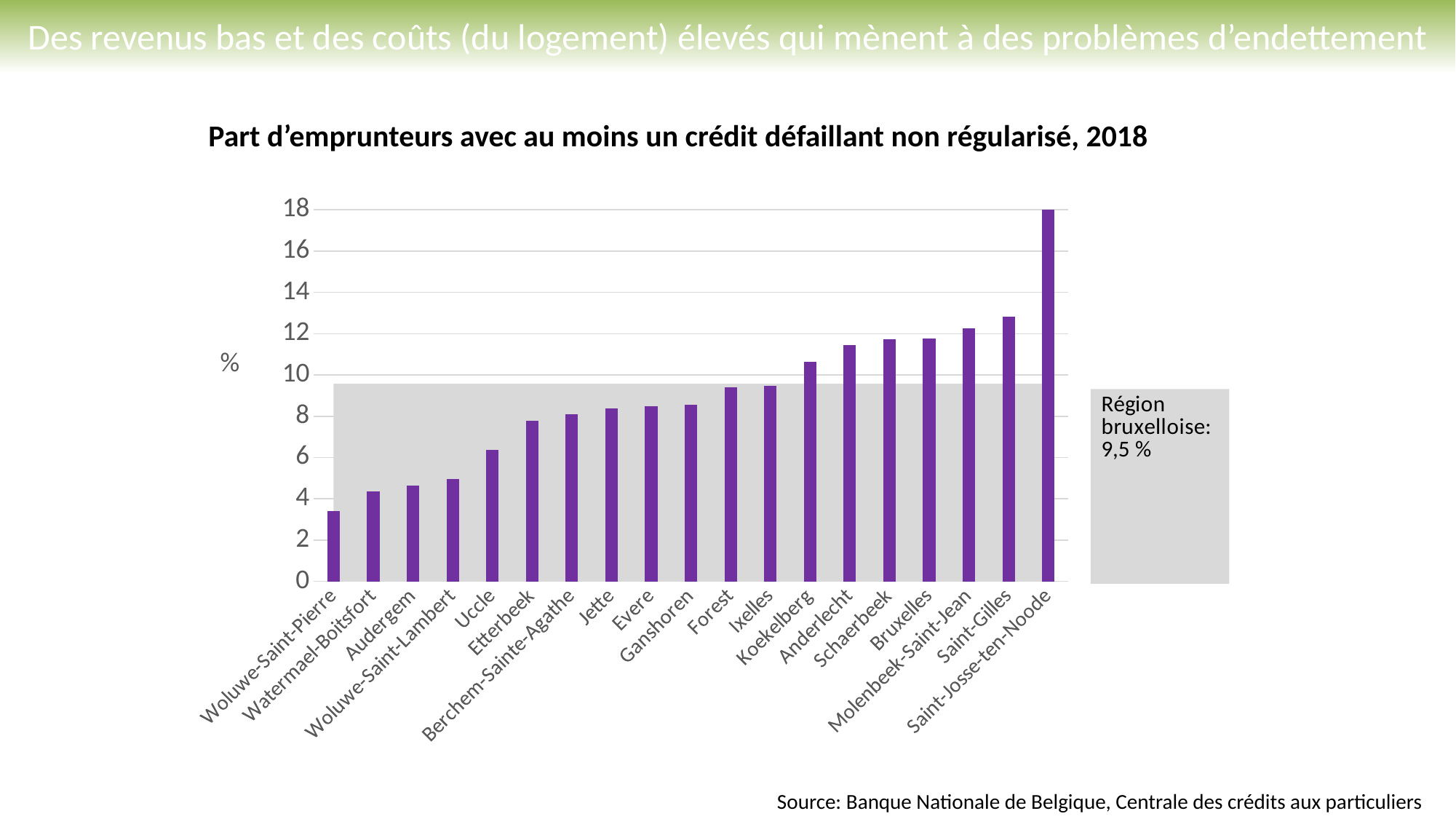
Is the value for Woluwe-Saint-Pierre greater or less than 4? less Do the values rise or fall moving from left to right along the x axis? rise Is the value for Saint-Gilles greater or less than 12? greater What is the title of the chart? Part d’emprunteurs avec au moins un crédit défaillant non régularisé, 2018 Which has a larger value, Koekelberg or Jette? Koekelberg Which commune has the highest share of borrowers with at least one unregularised defaulting credit? Saint-Josse-ten-Noode What type of chart is shown on the slide? bar chart How many communes (categories) are shown on the x axis of the chart? 19 What value is given for the Région bruxelloise on the slide? 9,5 % Is the value for Anderlecht greater or less than 10? greater Which commune has the lowest share of borrowers with at least one unregularised defaulting credit? Woluwe-Saint-Pierre